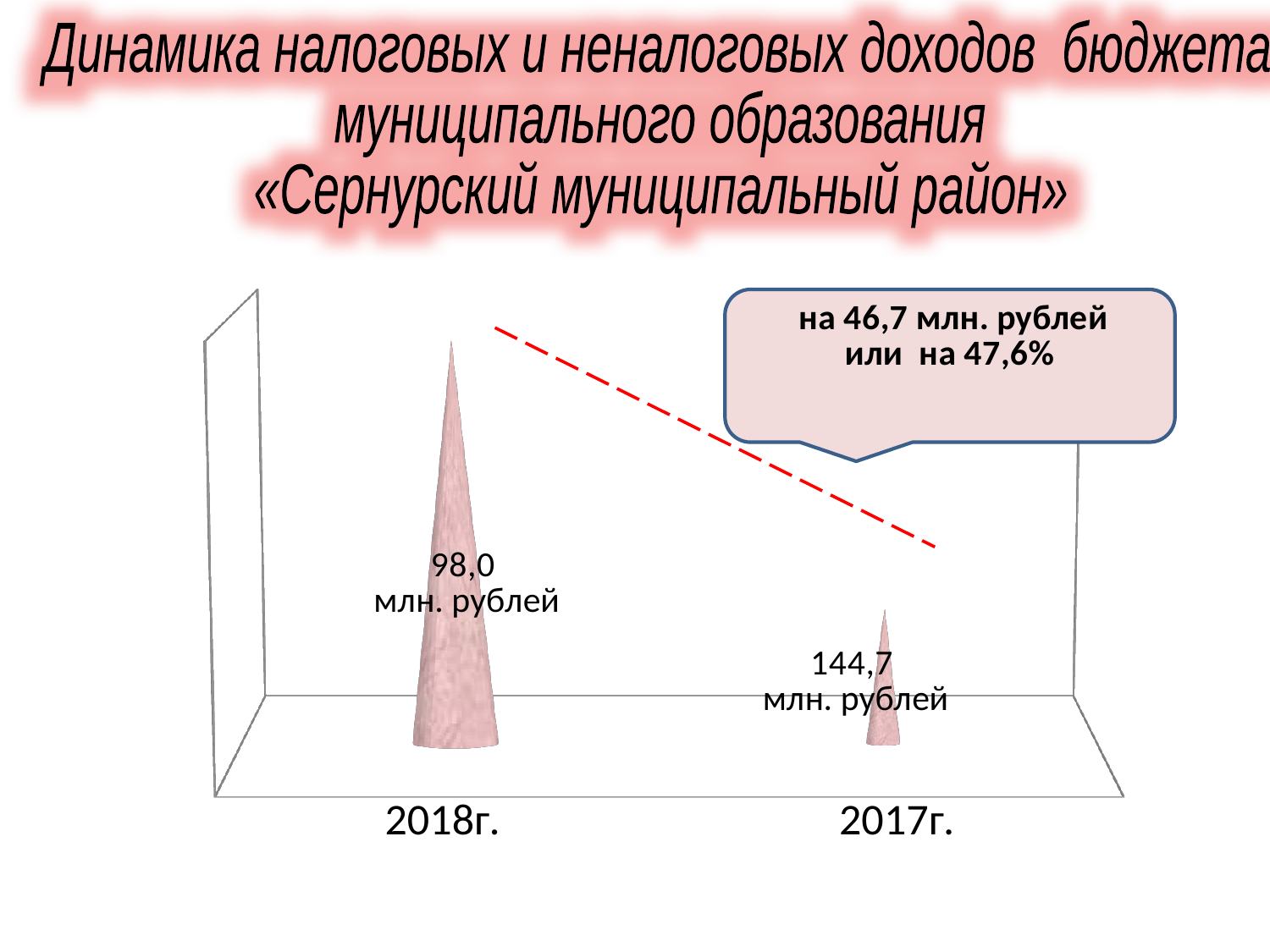
Is the labelled value for 2017г. greater or less than 100 млн. рублей? greater What value is labelled for 2018г.? 98,0 млн. рублей Which year is shown on the left of the chart? 2018г. How many categories (years) are shown on the chart? 2 According to the callout, by how many million rubles do the two values differ? 46,7 млн. рублей What value is labelled for 2017г.? 144,7 млн. рублей Is the labelled value for 2018г. greater or less than 100 млн. рублей? less According to the callout, what is the percentage change between the two years? 47,6% What kind of chart is shown on the slide? bar chart Which year has the larger labelled value, 2018г. or 2017г.? 2017г.